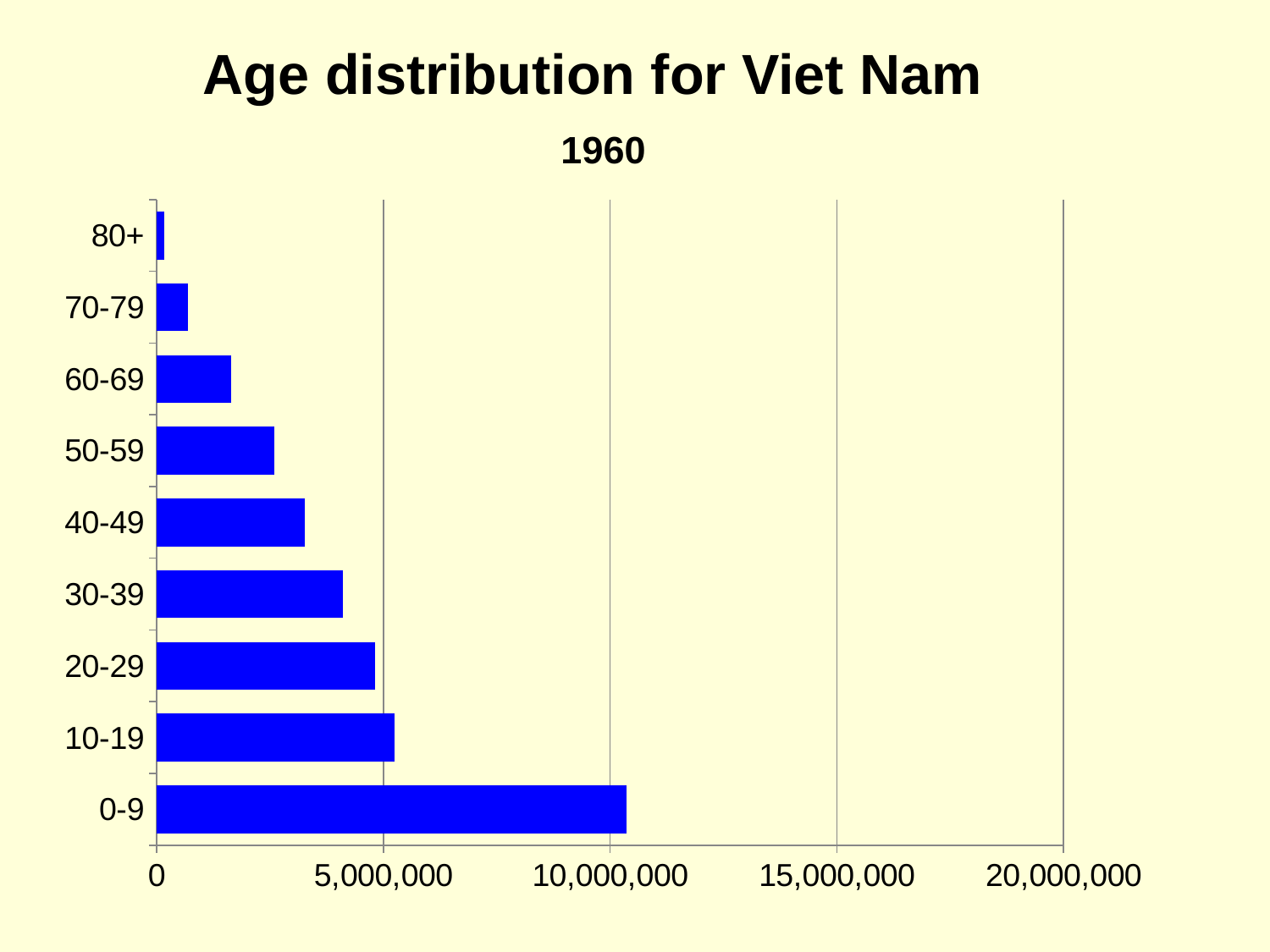
Which age group has the highest value? 0-9 Is the value for the 30-39 age group greater or less than 5,000,000? less What is the title of the chart? Age distribution for Viet Nam Which has a larger value, the 0-9 age group or the 10-19 age group? 0-9 Do the values rise or fall as the age groups get older, from 0-9 to 80+? fall Which age group has the lowest value? 80+ Is the value for the 60-69 age group greater or less than 5,000,000? less What year does the chart show data for? 1960 How many age groups are plotted in the chart? 9 Is the value for the 0-9 age group greater or less than 10,000,000? greater What kind of chart is shown on the slide? bar chart Which has a larger value, the 40-49 age group or the 60-69 age group? 40-49